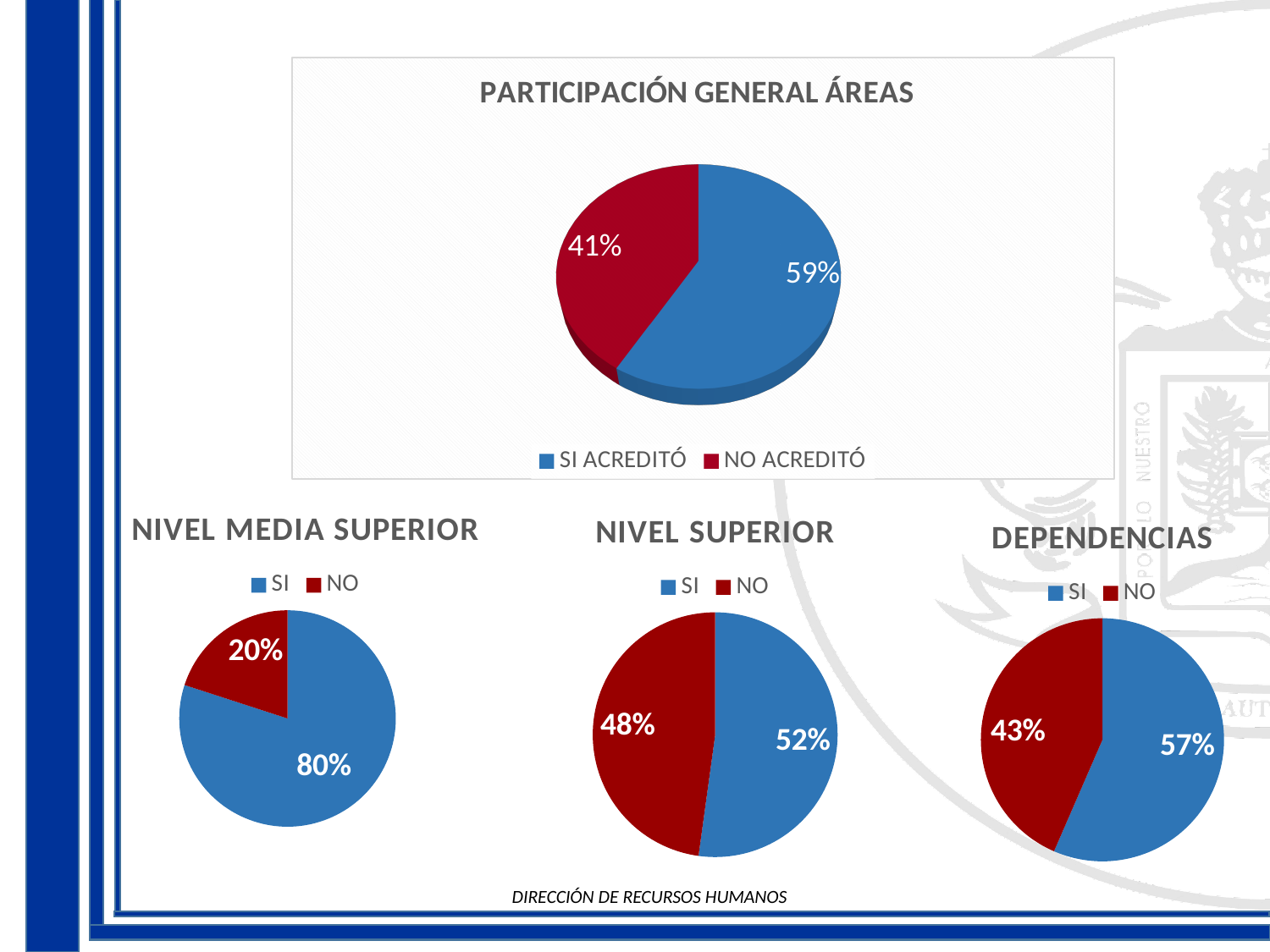
In the NIVEL SUPERIOR chart, which is larger, SI or NO? SI In the DEPENDENCIAS chart, what is the difference between SI and NO? 14% In the DEPENDENCIAS chart, what is the value for SI? 57% In the NIVEL MEDIA SUPERIOR chart, what is the difference between SI and NO? 60% In the PARTICIPACIÓN GENERAL ÁREAS chart, what share is NO ACREDITÓ? 41% What kind of chart is the PARTICIPACIÓN GENERAL ÁREAS chart? Pie chart What are the legend entries of the PARTICIPACIÓN GENERAL ÁREAS chart? SI ACREDITÓ, NO ACREDITÓ How many slices does the NIVEL SUPERIOR chart have? 2 In the NIVEL SUPERIOR chart, what is the value for NO? 48% In the NIVEL MEDIA SUPERIOR chart, what is the value for NO? 20% In the NIVEL MEDIA SUPERIOR chart, what is the value for SI? 80% In the PARTICIPACIÓN GENERAL ÁREAS chart, what share is SI ACREDITÓ? 59%